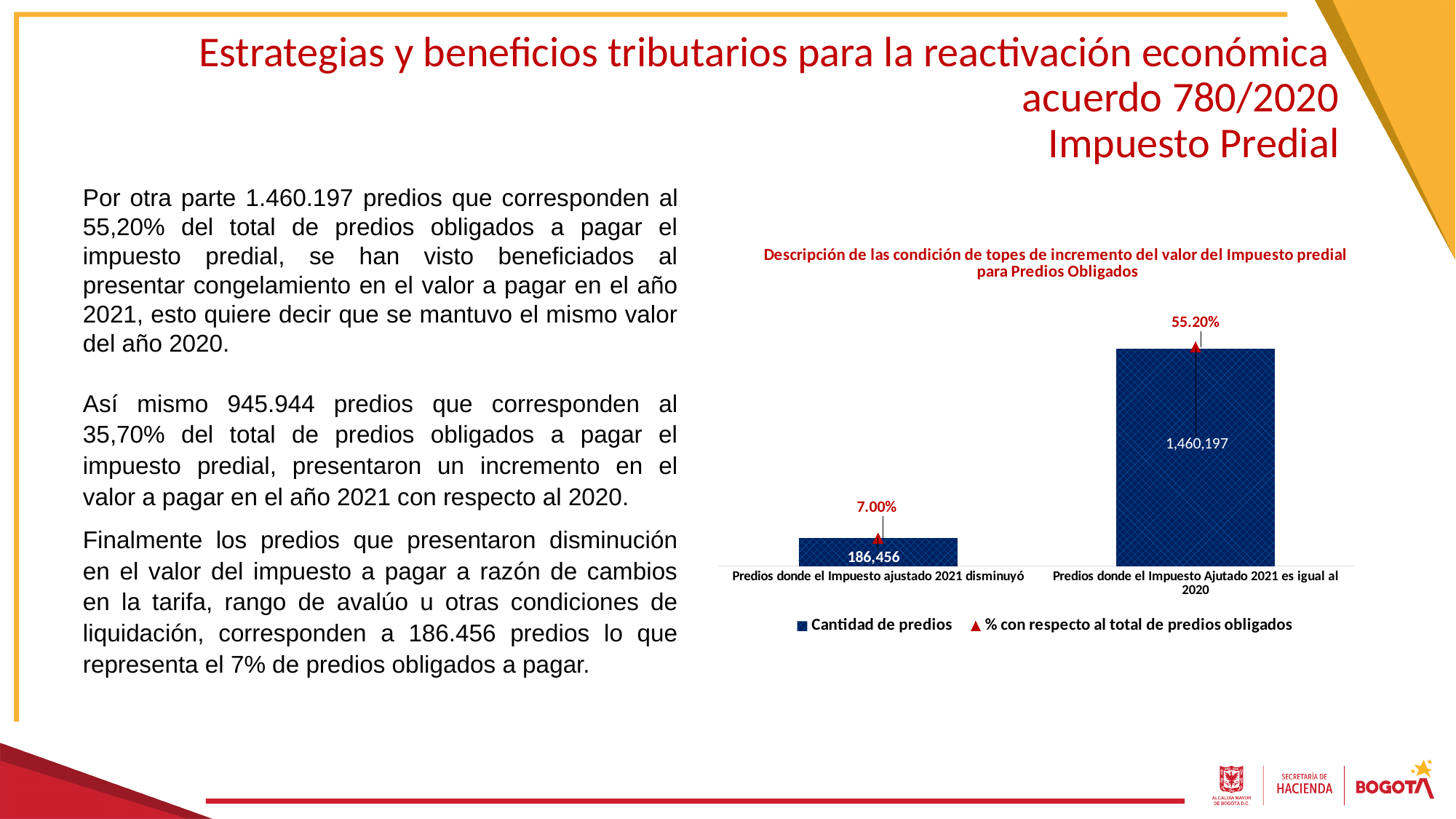
What is the '% con respecto al total de predios obligados' for 'Predios donde el Impuesto ajustado 2021 disminuyó'? 7.00% What is the value of 'Cantidad de predios' for 'Predios donde el Impuesto Ajutado 2021 es igual al 2020'? 1,460,197 What is the '% con respecto al total de predios obligados' for 'Predios donde el Impuesto Ajutado 2021 es igual al 2020'? 55.20% Which category has the highest 'Cantidad de predios'? Predios donde el Impuesto Ajutado 2021 es igual al 2020 What is the title of the chart? Descripción de las condición de topes de incremento del valor del Impuesto predial para Predios Obligados Which category has the lowest 'Cantidad de predios'? Predios donde el Impuesto ajustado 2021 disminuyó What is the difference in 'Cantidad de predios' between the two categories? 1,273,741 How many categories are shown on the x axis of the chart? 2 How many series does the chart legend list? 2 What is the difference in '% con respecto al total de predios obligados' between the two categories? 48.20% Which category has a larger '% con respecto al total de predios obligados'? Predios donde el Impuesto Ajutado 2021 es igual al 2020 What is the value of 'Cantidad de predios' for 'Predios donde el Impuesto ajustado 2021 disminuyó'? 186,456